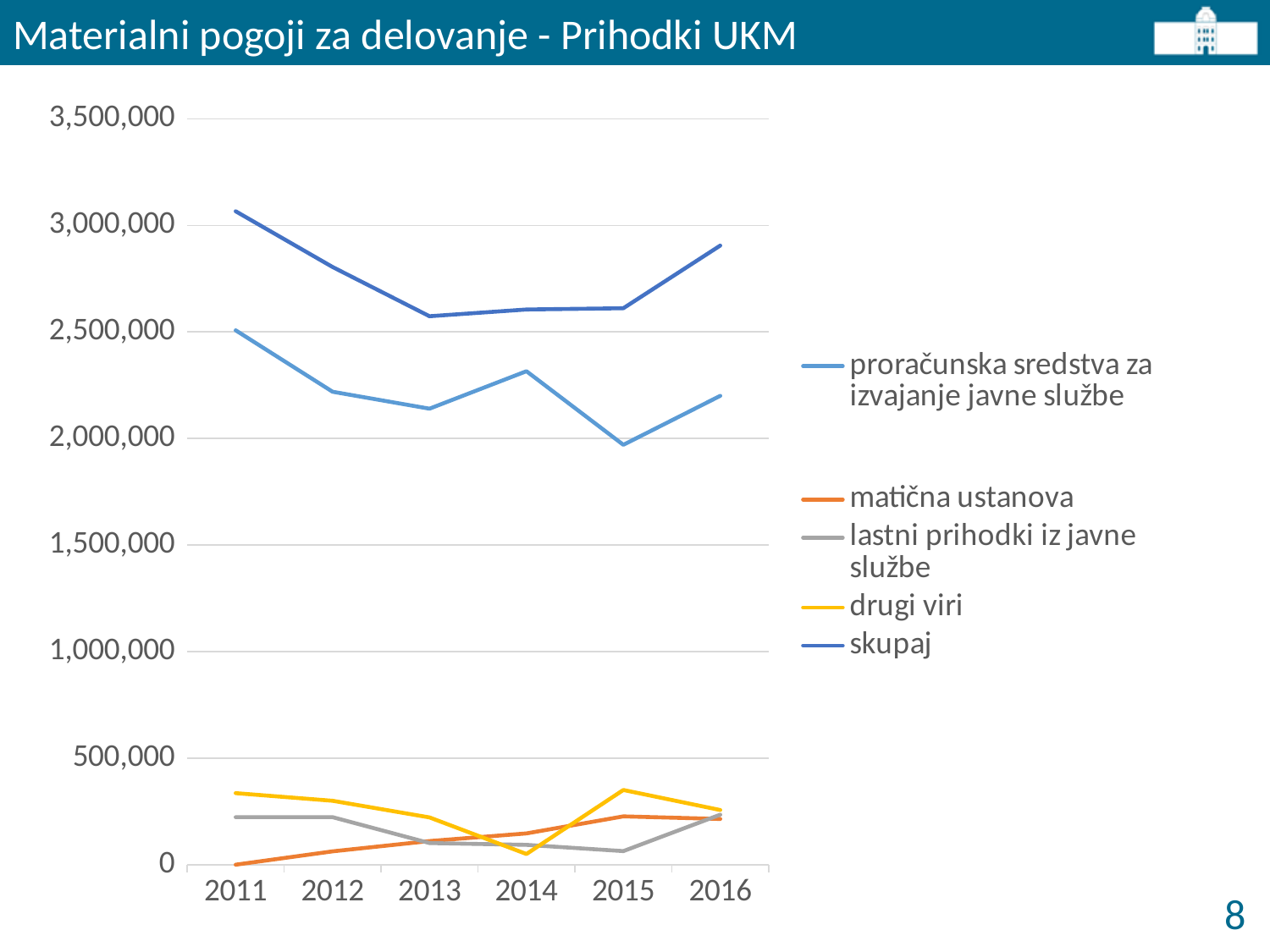
Is the value for proračunska sredstva za izvajanje javne službe in 2015 greater or less than 2,000,000? less Which is larger, the value for skupaj in 2011 or in 2016? 2011 Is the value for skupaj in 2013 greater or less than 3,000,000? less In which year is the value for drugi viri lowest? 2014 How many years are shown on the x axis? 6 In which year is the value for proračunska sredstva za izvajanje javne službe lowest? 2015 How many series does the legend list? 5 Is the value for skupaj in 2011 greater or less than 3,000,000? greater What is the title of the slide? Materialni pogoji za delovanje - Prihodki UKM Does the value for matična ustanova rise or fall from 2011 to 2015? rise In which year is the value for skupaj highest? 2011 What kind of chart is shown on the slide? line chart